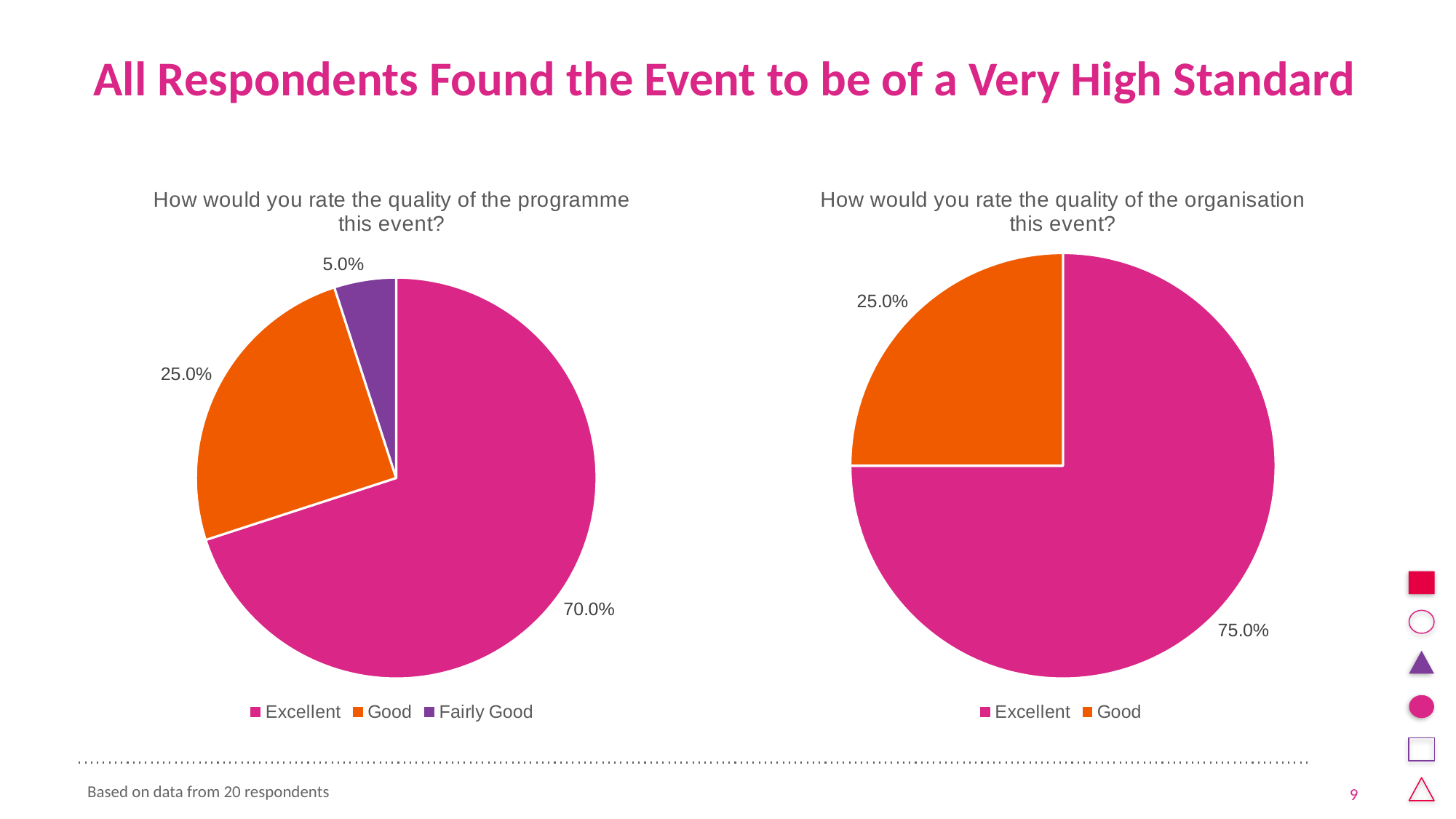
In the right chart (quality of the organisation), what share of respondents rated it Excellent? 75.0% In the left chart (quality of the programme), what share of respondents rated it Excellent? 70.0% In the left chart (quality of the programme), what colour is the Good slice? Orange In the left chart (quality of the programme), which rating has the smallest slice? Fairly Good What type of chart is used on the right side of the slide (quality of the organisation)? Pie chart In the left chart (quality of the programme), what is the difference in percentage points between the Excellent and Good slices? 45.0% How many categories does the legend of the left chart (quality of the programme) list? 3 In the left chart (quality of the programme), what share of respondents rated it Fairly Good? 5.0% In the right chart (quality of the organisation), which slice is larger, Excellent or Good? Excellent In the left chart (quality of the programme), which rating has the largest slice? Excellent In the right chart (quality of the organisation), what share of respondents rated it Good? 25.0% How many categories does the legend of the right chart (quality of the organisation) list? 2